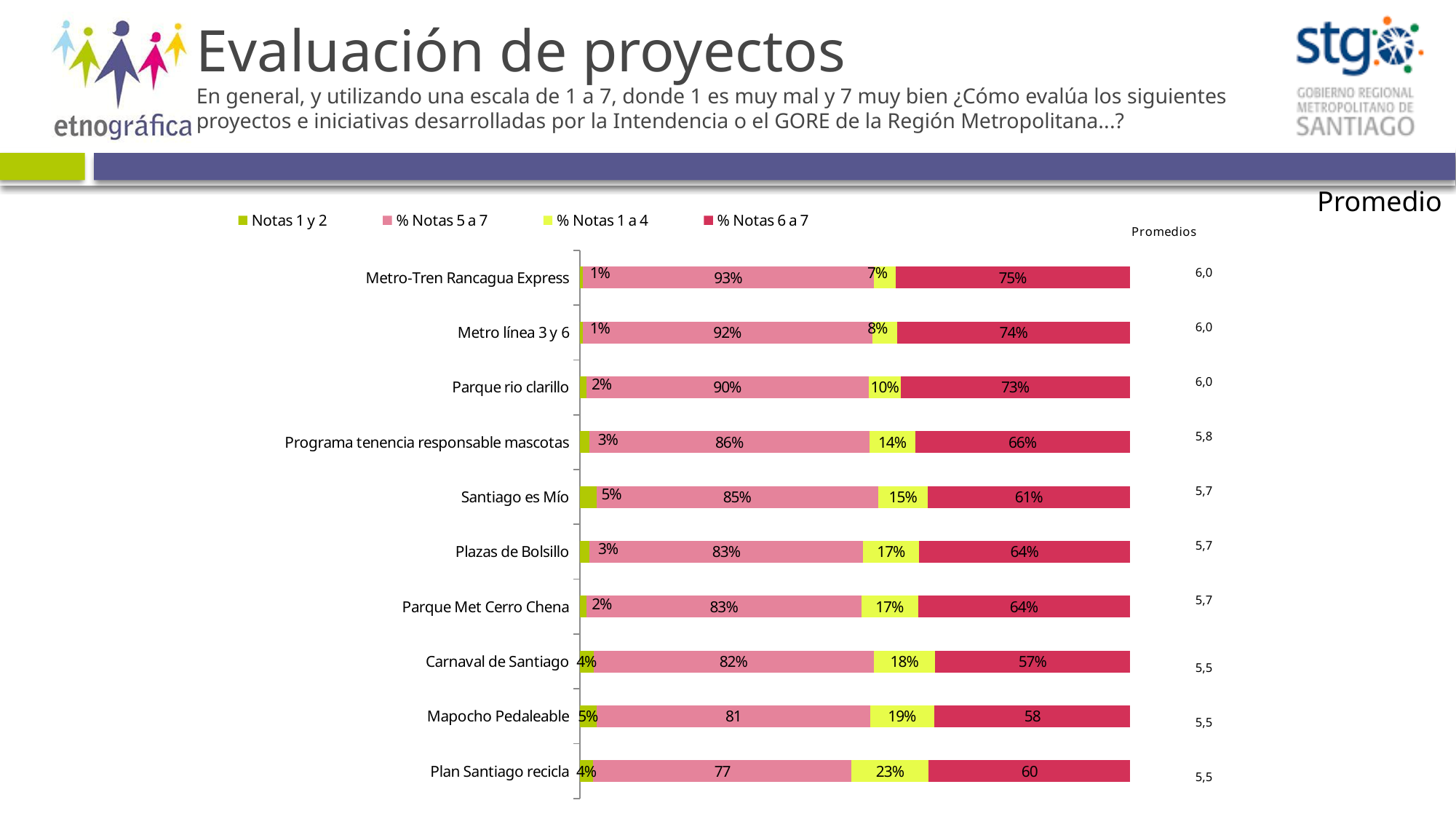
What is the % Notas 6 a 7 value for Metro-Tren Rancagua Express? 75% What is the Notas 1 y 2 value for Santiago es Mío? 5% Which project has the highest % Notas 6 a 7 value? Metro-Tren Rancagua Express Which has a larger % Notas 1 a 4 value, Parque rio clarillo or Mapocho Pedaleable? Mapocho Pedaleable Which project has the lowest % Notas 5 a 7 value? Plan Santiago recicla What kind of chart is shown on the slide? Stacked bar chart How many projects are listed on the chart? 10 What is the difference between the % Notas 6 a 7 values for Metro línea 3 y 6 and Carnaval de Santiago? 17% How many series does the legend list? 4 What is the % Notas 5 a 7 value for Programa tenencia responsable mascotas? 86% What is the Promedio shown for Parque Met Cerro Chena? 5,7 What is the % Notas 1 a 4 value for Plan Santiago recicla? 23%